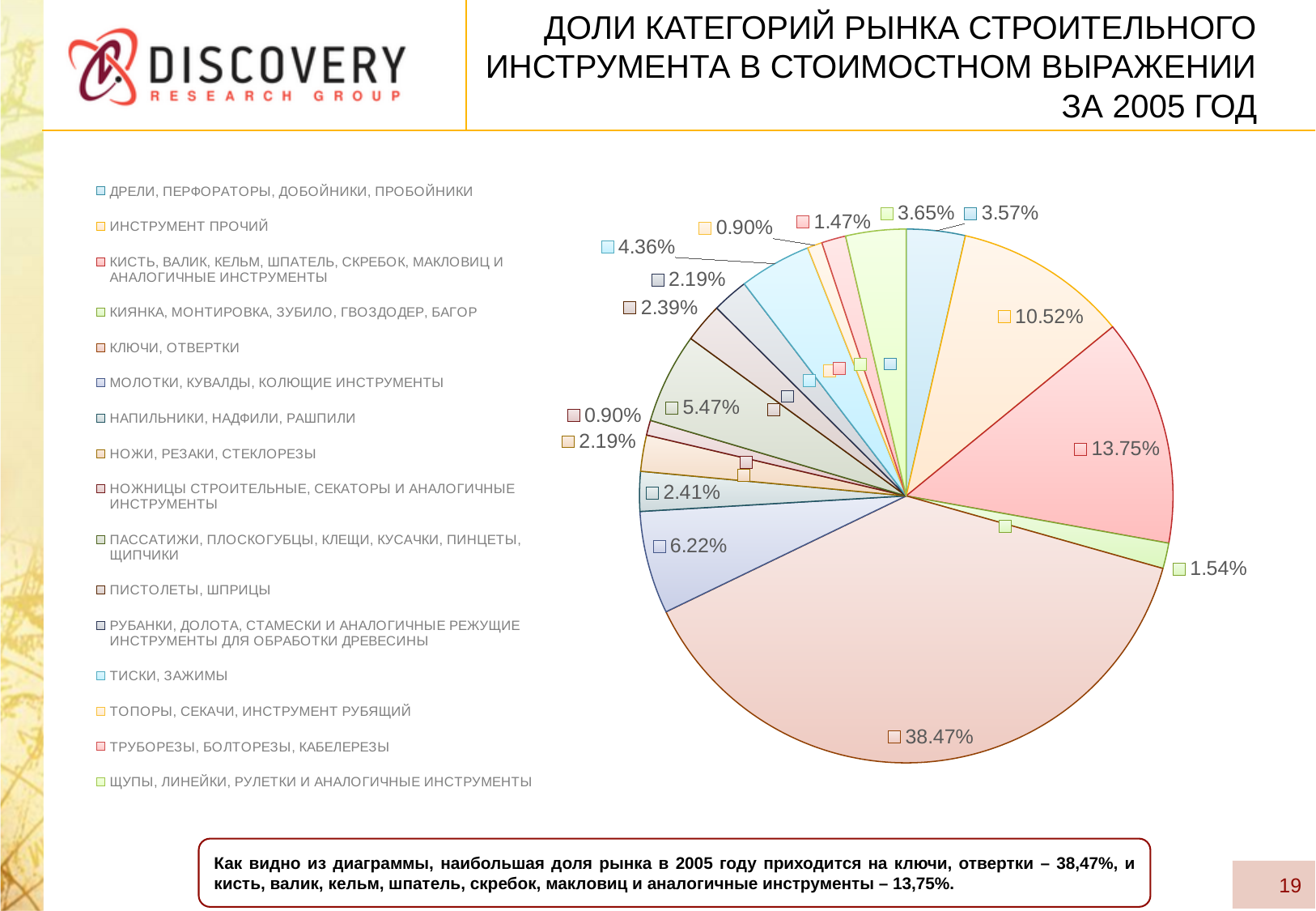
What kind of chart is shown on the slide? pie chart Which year does the chart title say the market shares are for? 2005 Which category has the largest share of the pie chart? КЛЮЧИ, ОТВЕРТКИ How many categories does the pie chart's legend list? 16 What is the difference in percentage points between the share for КЛЮЧИ, ОТВЕРТКИ and the share for КИСТЬ, ВАЛИК, КЕЛЬМ, ШПАТЕЛЬ, СКРЕБОК, МАКЛОВИЦ И АНАЛОГИЧНЫЕ ИНСТРУМЕНТЫ? 24.72 What is the combined share of the two largest slices, КЛЮЧИ, ОТВЕРТКИ and КИСТЬ, ВАЛИК, КЕЛЬМ, ШПАТЕЛЬ, СКРЕБОК, МАКЛОВИЦ И АНАЛОГИЧНЫЕ ИНСТРУМЕНТЫ? 52.22% What is the share for КИСТЬ, ВАЛИК, КЕЛЬМ, ШПАТЕЛЬ, СКРЕБОК, МАКЛОВИЦ И АНАЛОГИЧНЫЕ ИНСТРУМЕНТЫ? 13.75% What is the share for ДРЕЛИ, ПЕРФОРАТОРЫ, ДОБОЙНИКИ, ПРОБОЙНИКИ? 3.57% What is the share for МОЛОТКИ, КУВАЛДЫ, КОЛЮЩИЕ ИНСТРУМЕНТЫ? 6.22% Which has a larger share: ИНСТРУМЕНТ ПРОЧИЙ or МОЛОТКИ, КУВАЛДЫ, КОЛЮЩИЕ ИНСТРУМЕНТЫ? ИНСТРУМЕНТ ПРОЧИЙ What is the share for КЛЮЧИ, ОТВЕРТКИ? 38.47% What is the share for ИНСТРУМЕНТ ПРОЧИЙ? 10.52%